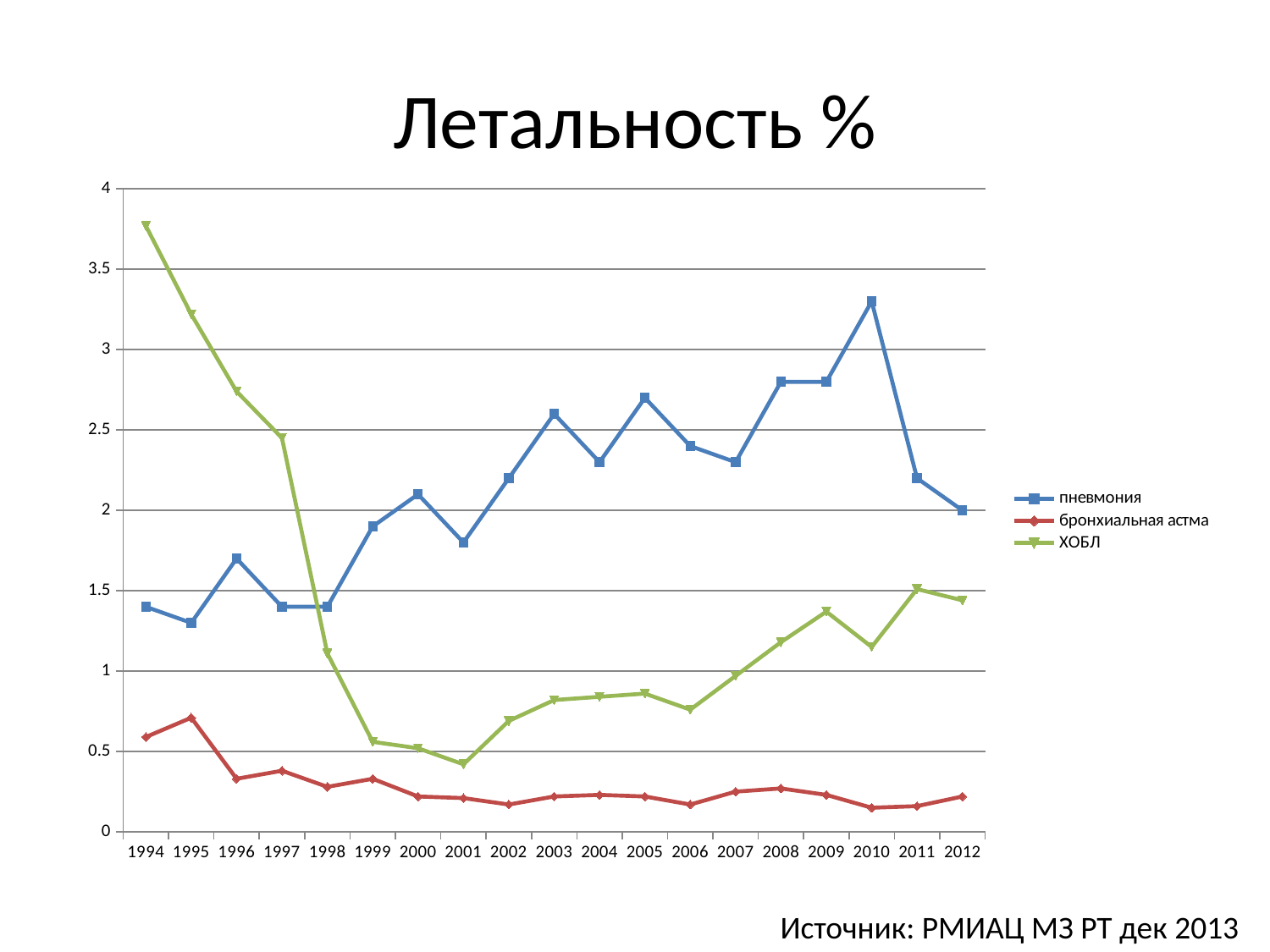
Is the value for бронхиальная астма in 1995 greater or less than 0.5? greater How many series does the legend list? 3 Is the value for пневмония in 2010 greater or less than 3? greater What kind of chart is shown on the slide? line chart How many years are shown on the x axis? 19 Which series has the highest value in 1994? ХОБЛ In which year does the пневмония series reach its highest value? 2010 Is the value for ХОБЛ in 1994 greater or less than 3.5? greater In which year does the ХОБЛ series reach its lowest value? 2001 In 2012, which series has the larger value: пневмония or ХОБЛ? пневмония What is the title of the chart? Летальность % Does the ХОБЛ series rise or fall from 1994 to 1999? fall